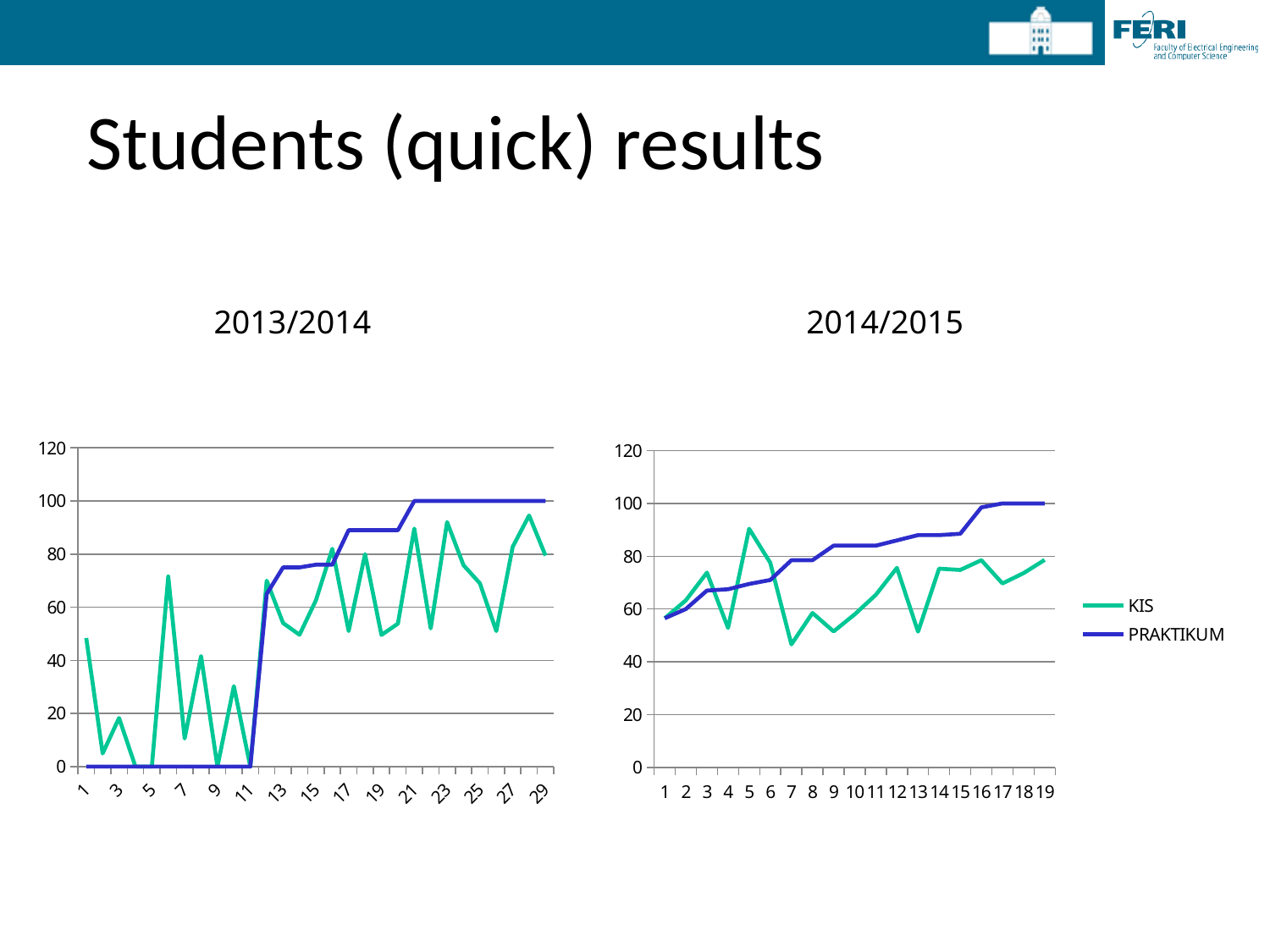
In the 2014/2015 chart, what is the PRAKTIKUM value at point 19? 100 In the 2013/2014 chart, what is the PRAKTIKUM value at point 1? 0 How many series does the legend list for the charts? 2 In the 2014/2015 chart, which series has the higher value at point 13, KIS or PRAKTIKUM? PRAKTIKUM In the 2014/2015 chart, how many points are plotted along the x axis? 19 In the 2013/2014 chart, how many points are plotted along the x axis? 29 What kind of chart is the 2013/2014 chart? line chart In the 2014/2015 chart, is the KIS value at point 7 greater or less than 60? less In the 2013/2014 chart, is the KIS value at point 6 greater or less than 60? greater In the 2014/2015 chart, is the PRAKTIKUM value at point 16 greater or less than 80? greater In the 2014/2015 chart, does the PRAKTIKUM line generally rise or fall along the x axis? rise What colour is the KIS line in the legend? green